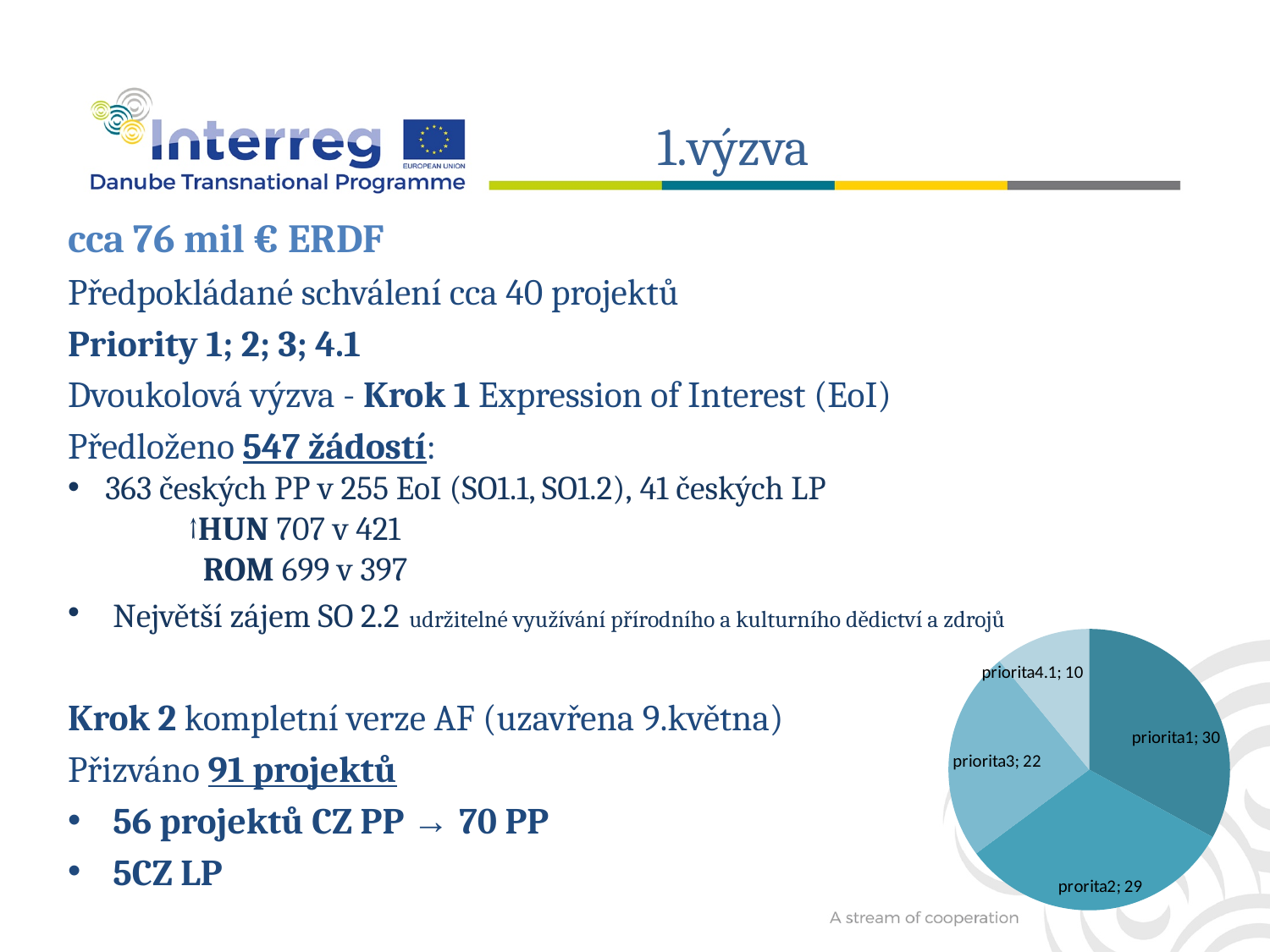
What is the value for prorita2 in the pie chart? 29 What is the difference between the values for prorita2 and priorita3 in the pie chart? 7 What is the difference between the values for priorita1 and priorita4.1 in the pie chart? 20 Which is larger in the pie chart, priorita3 or priorita4.1? priorita3 What is the value for priorita3 in the pie chart? 22 What kind of chart is shown on the slide? pie chart Which slice of the pie chart has the smallest value? priorita4.1 How many slices does the pie chart have? 4 What is the value for priorita4.1 in the pie chart? 10 Which slice of the pie chart has the largest value? priorita1 What is the total of all slice values in the pie chart? 91 What is the value for priorita1 in the pie chart? 30